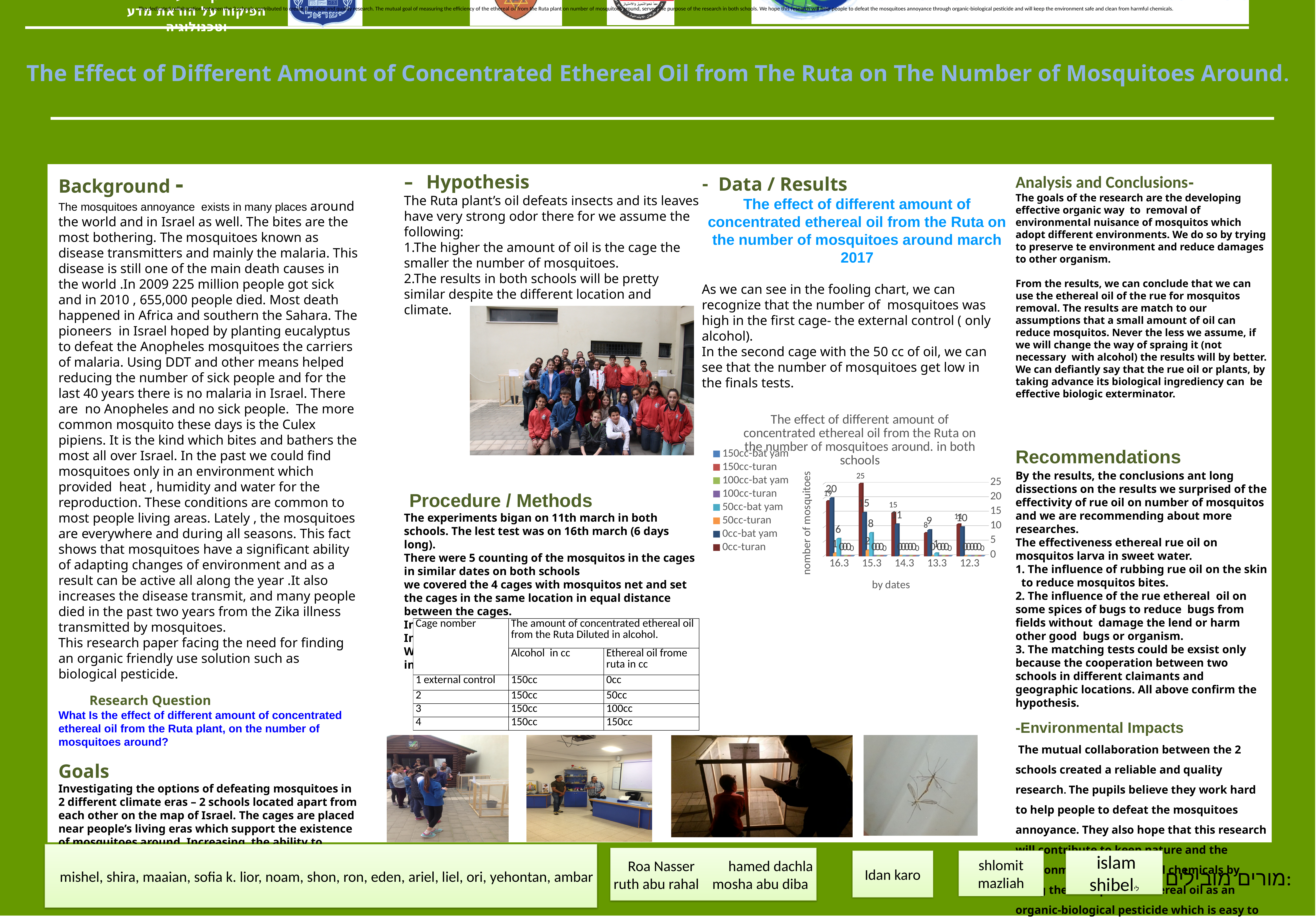
Is the value for 0cc-bat yam on 16.3 greater or less than 15? greater Is the value for 0cc-turan on 15.3 greater or less than 20? greater Is the value for 50cc-bat yam on 16.3 greater or less than 10? less What is the highest value labelled on any bar in the chart? 25 What kind of chart is shown in the Data / Results section? bar chart What is the title of the chart's vertical axis? nomber of mosquitoes How many dates are shown along the x axis of the chart? 5 What is the value for 0cc-turan on 15.3? 25 How many series does the chart legend list? 8 On which date does the tallest bar in the chart appear? 15.3 What is the title of the chart's horizontal axis? by dates